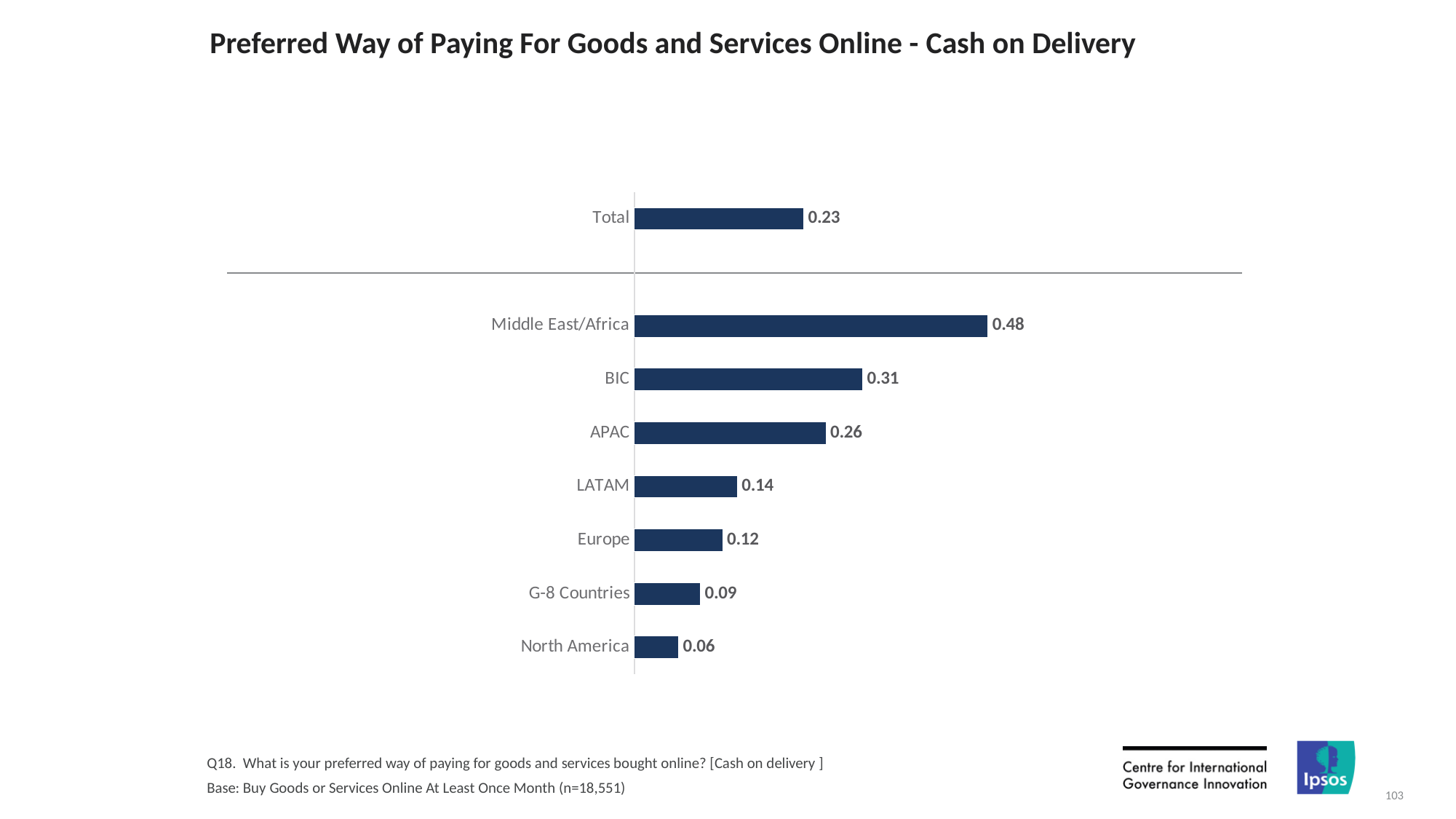
What is the title of the chart? Preferred Way of Paying For Goods and Services Online - Cash on Delivery What is the value for G-8 Countries? 0.09 How many bars are shown in the chart? 8 Which region has the highest value? Middle East/Africa What is the difference between the values for Middle East/Africa and North America? 0.42 What is the value for Europe? 0.12 Which region has the lowest value? North America What is the difference between the values for BIC and APAC? 0.05 Which is larger, the value for LATAM or the value for Europe? LATAM What is the value for Middle East/Africa? 0.48 What is the value for Total? 0.23 What kind of chart is shown on the slide? Bar chart